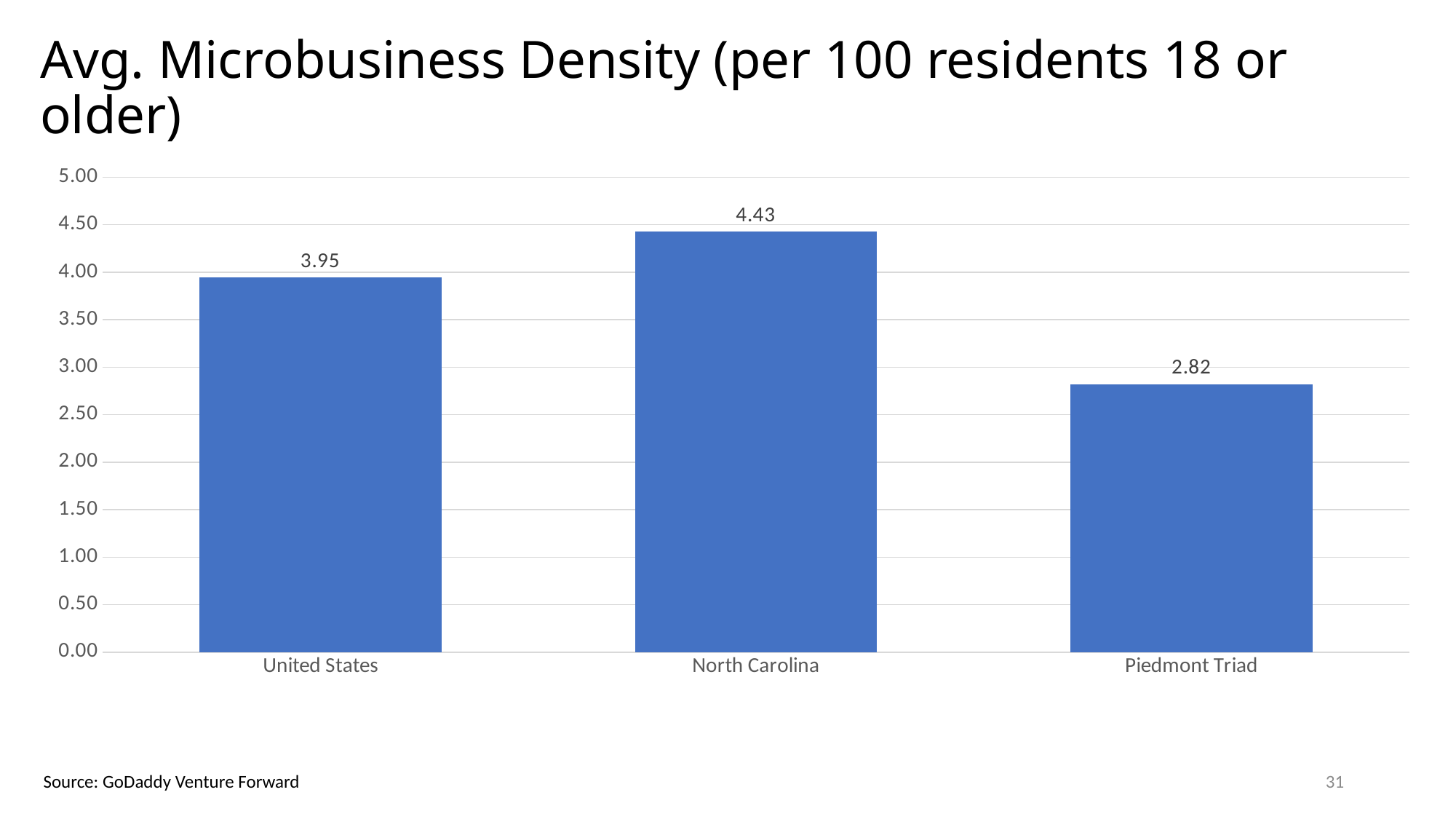
Which category has the lowest average microbusiness density? Piedmont Triad Which is larger, the value for North Carolina or the value for Piedmont Triad? North Carolina How many categories are shown on the chart? 3 What is the difference between the values for North Carolina and the United States? 0.48 What is the average microbusiness density for the United States? 3.95 What is the source cited for the chart? GoDaddy Venture Forward What kind of chart is shown on the slide? Bar chart Which category has the highest average microbusiness density? North Carolina Is the value for Piedmont Triad greater or less than 3.00? less What is the average microbusiness density for Piedmont Triad? 2.82 What is the average microbusiness density for North Carolina? 4.43 What is the difference between the values for the United States and Piedmont Triad? 1.13